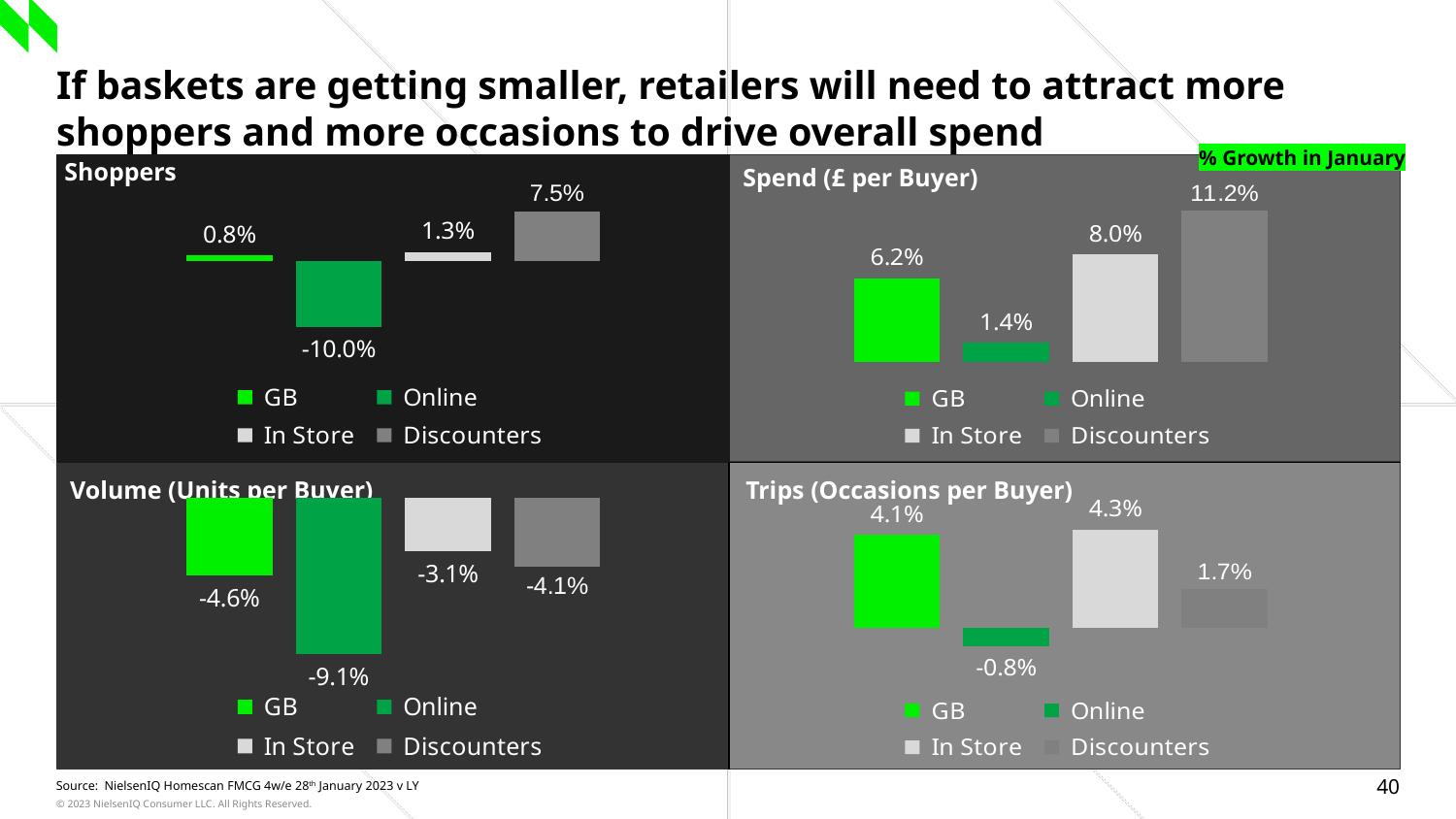
In the Spend (£ per Buyer) chart, which series has the lowest value? Online What kind of chart is the Spend (£ per Buyer) chart? Bar chart In the Trips (Occasions per Buyer) chart, what is the value for Online? -0.8% In the Shoppers chart, which series has the highest value? Discounters In the Trips (Occasions per Buyer) chart, which is larger, the value for GB or the value for Discounters? GB How many series does the legend of the Shoppers chart list? 4 In the Shoppers chart, what is the value for Online? -10.0% In the Volume (Units per Buyer) chart, what is the value for GB? -4.6% In the Spend (£ per Buyer) chart, what is the value for Discounters? 11.2% In the Shoppers chart, what is the difference between the Discounters and In Store values? 6.2% In the Volume (Units per Buyer) chart, which series has the lowest value? Online In the Spend (£ per Buyer) chart, what is the difference between the In Store and GB values? 1.8%